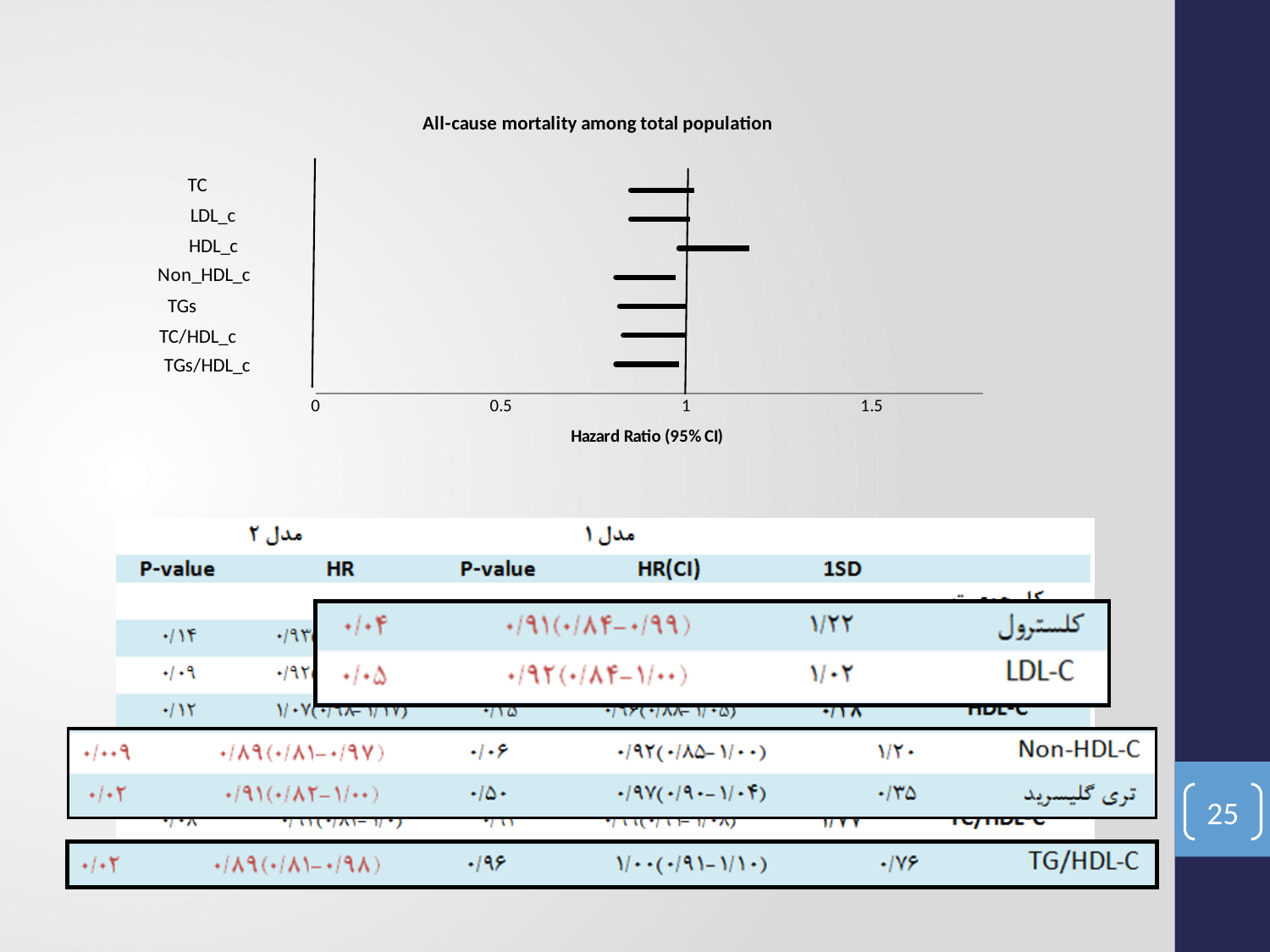
Is the bar for TGs/HDL_c entirely greater or less than 1 on the Hazard Ratio axis? less Which category's bar extends furthest to the right on the chart? HDL_c Which category is listed first (at the top) of the chart? TC Is the right end of the HDL_c bar greater or less than 1 on the Hazard Ratio axis? greater What is the title of the chart? All-cause mortality among total population What kind of chart is shown on the slide? Horizontal bar chart Which bar reaches a higher hazard ratio at its right end, HDL_c or Non_HDL_c? HDL_c Is the bar for Non_HDL_c entirely greater or less than 1 on the Hazard Ratio axis? less What is the label of the horizontal axis of the chart? Hazard Ratio (95% CI) How many categories are plotted on the chart? 7